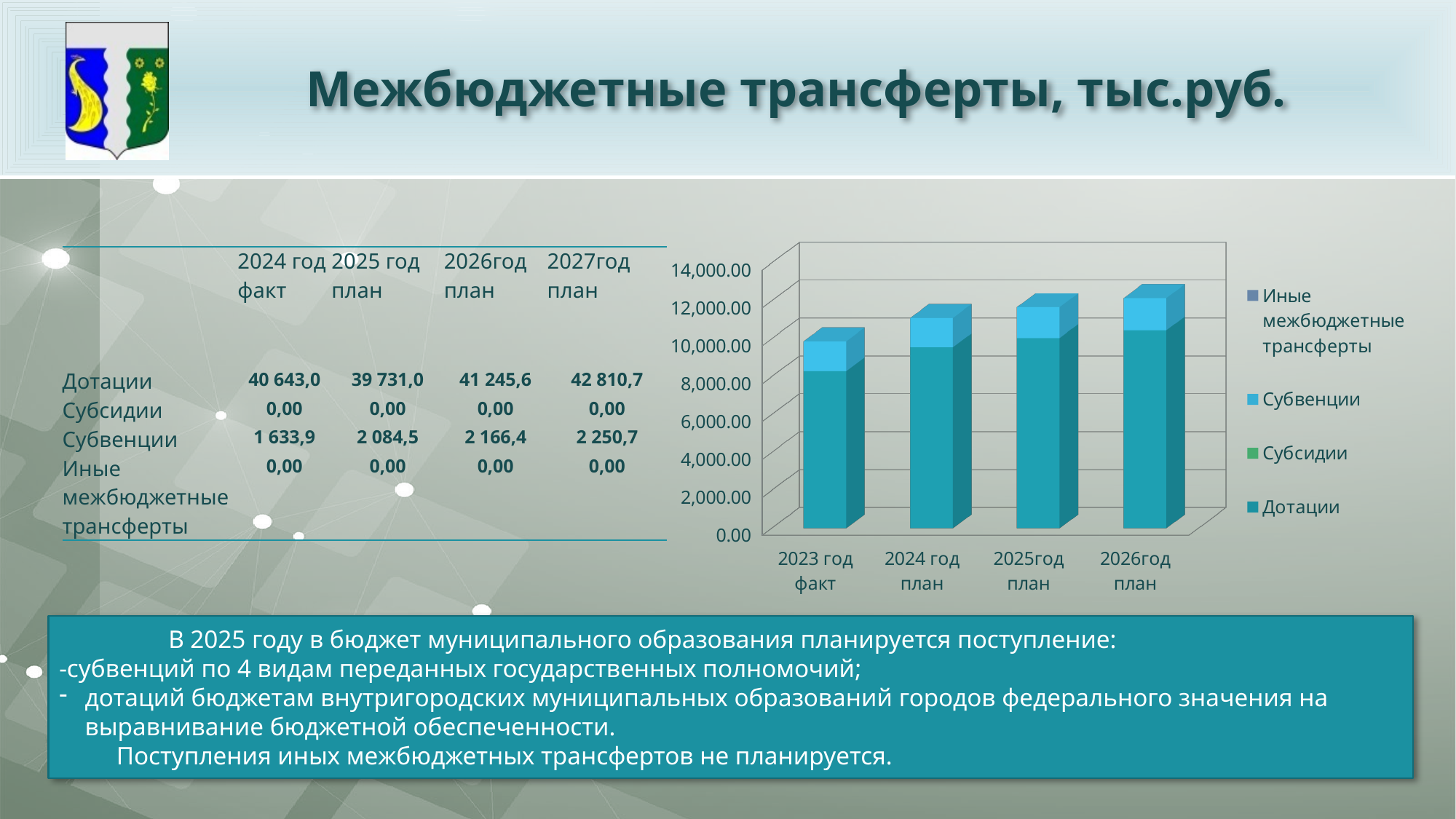
Which category has the shortest stacked bar in the chart? 2023 год факт Which series is listed last in the chart legend? Дотации Is the total stacked bar for 2026год план greater or less than 10,000.00? greater How many series does the chart legend list? 4 Is the Дотации value for 2023 год факт greater or less than 10,000.00? less What kind of chart is shown on the slide? bar chart Which category has the tallest stacked bar in the chart? 2026год план How many categories are shown on the x axis of the chart? 4 Is the Дотации value for 2026год план greater or less than 8,000.00? greater Do the total heights of the stacked bars rise or fall from 2023 год факт to 2026год план? rise Which is larger in the chart: the Дотации value for 2025год план or for 2023 год факт? 2025год план What is the first category on the x axis of the chart? 2023 год факт